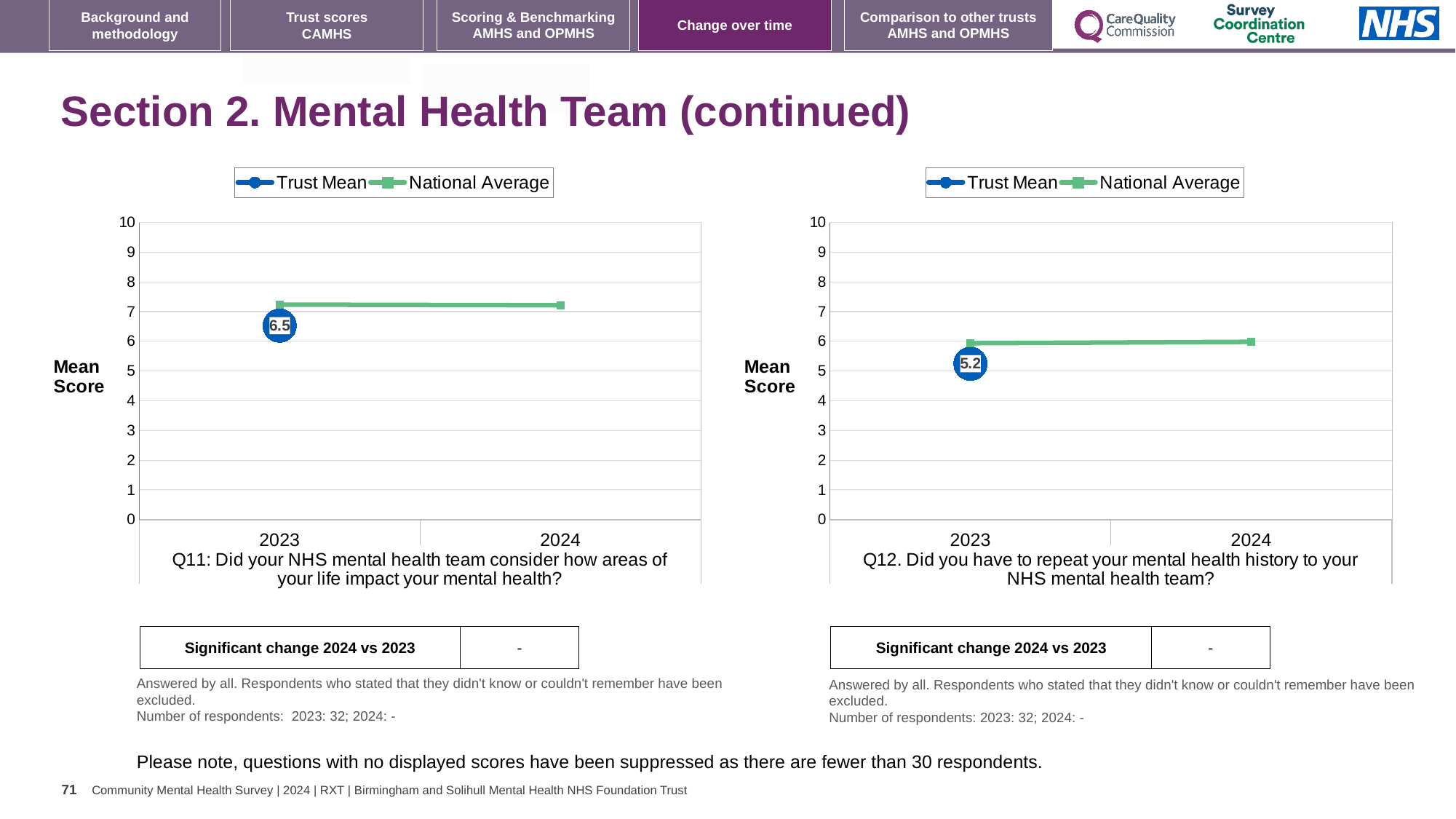
In the left chart (Q11), which is higher in 2023: the Trust Mean or the National Average? National Average In the right chart (Q12), which is higher in 2023: the Trust Mean or the National Average? National Average How many series does the legend of the right chart (Q12) list? 2 In the left chart (Q11), is the National Average value for 2024 greater or less than 6? greater How many years are shown on the x axis of the left chart (Q11)? 2 What are the two series named in the legend of the left chart (Q11)? Trust Mean and National Average In the right chart (Q12), is the National Average value for 2023 greater or less than 7? less What kind of chart is the left chart (Q11)? Line chart In the right chart (Q12), what is the Trust Mean score for 2023? 5.2 In the left chart (Q11), what is the Trust Mean score for 2023? 6.5 In the right chart (Q12), is the Trust Mean value for 2023 greater or less than 5? greater What is the y-axis label on the right chart (Q12)? Mean Score